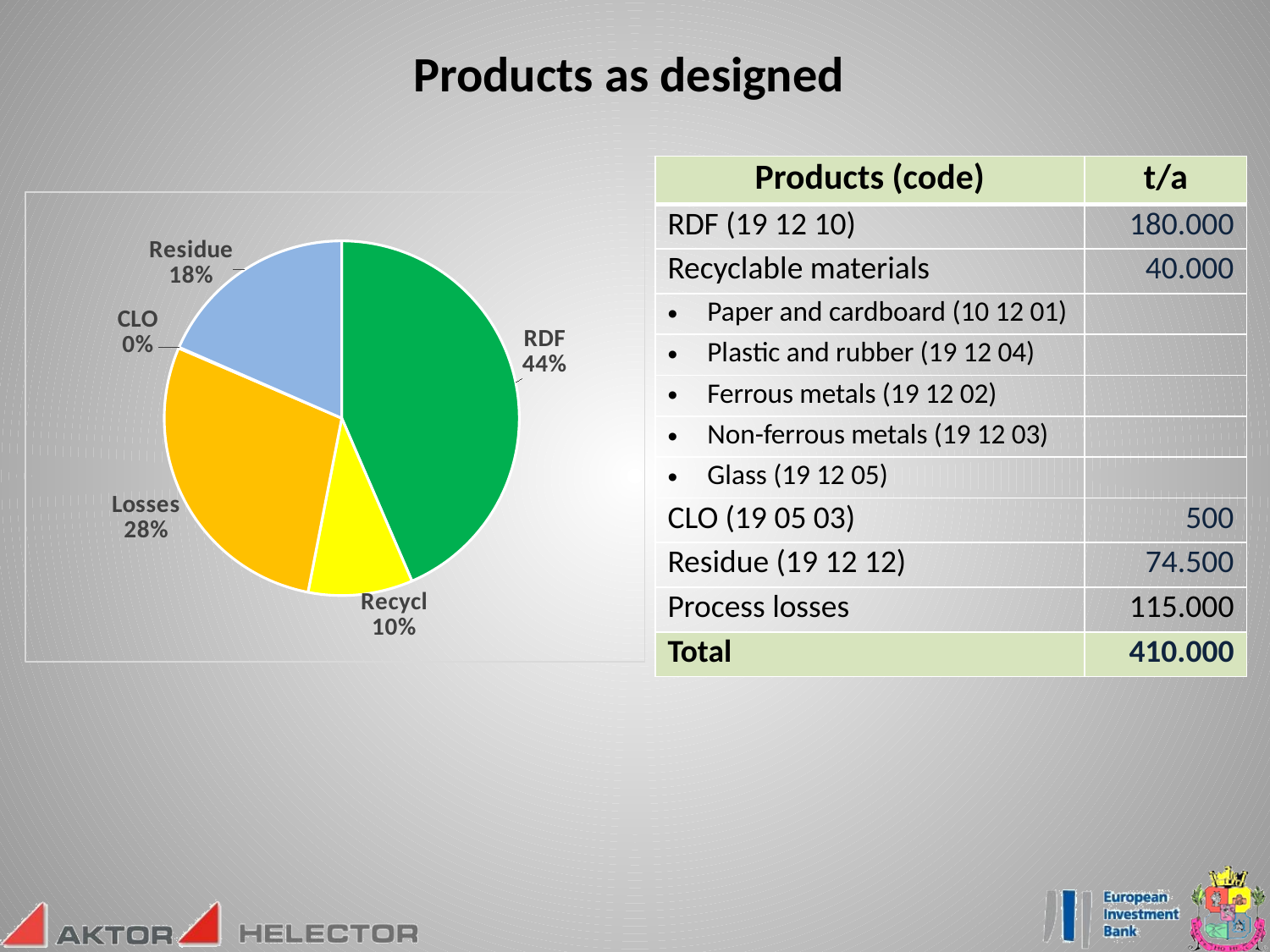
What colour is the RDF slice in the pie chart? green What share of the pie does Residue represent? 18% Which slice of the pie chart is the largest? RDF What is the difference in percentage points between the RDF and Losses slices? 16% What kind of chart is shown on the slide? pie chart What share of the pie does Losses represent? 28% Which slice is larger, Residue or Recycl? Residue How many slices are labelled in the pie chart? 5 What share of the pie does Recycl represent? 10% Which slice of the pie chart is the smallest? CLO